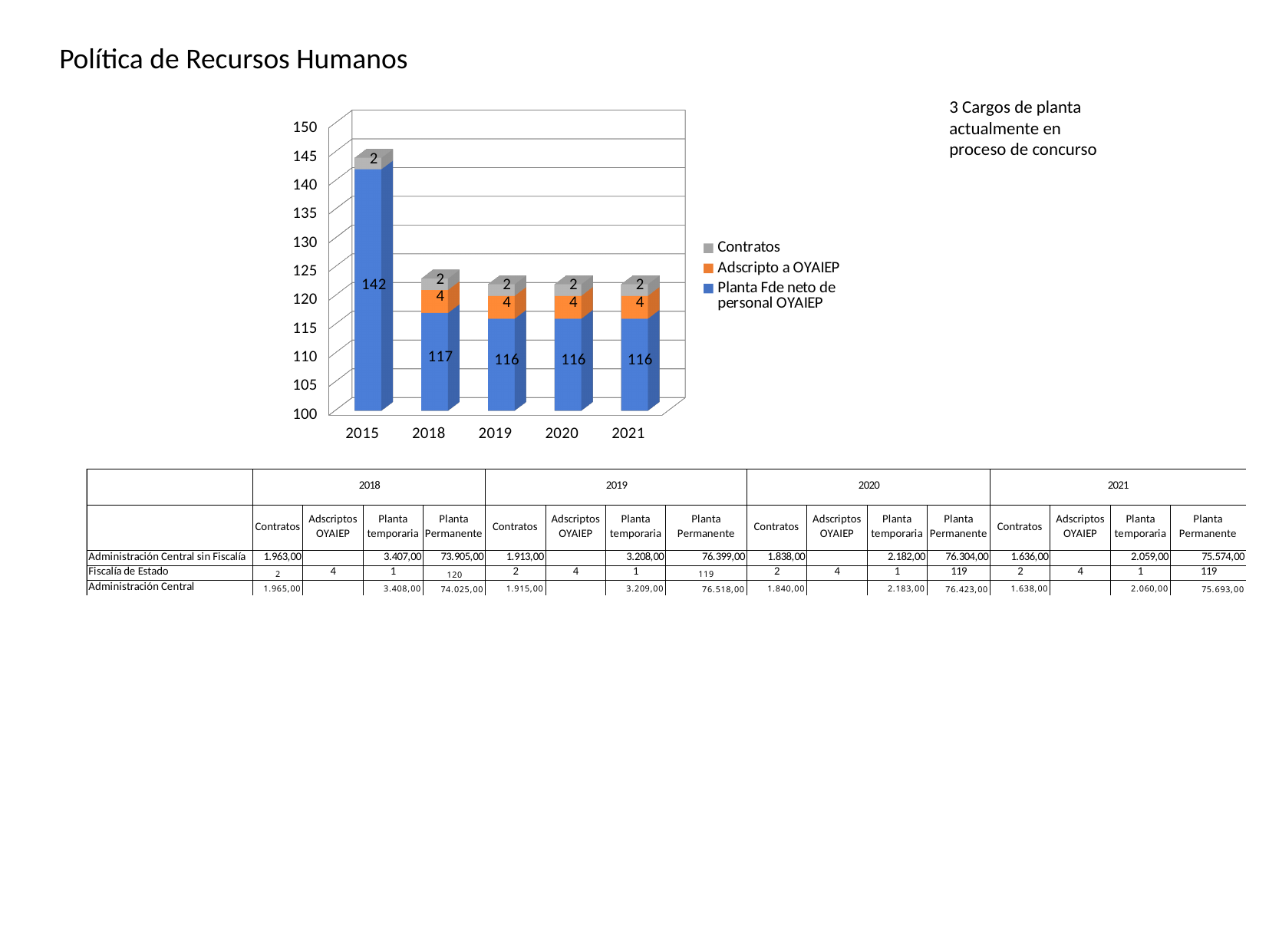
Which year has the highest value for the Planta Fde neto de personal OYAIEP series? 2015 What is the difference between the Planta Fde neto de personal OYAIEP values for 2015 and 2018? 25 How many years are shown on the x axis of the chart? 5 What is the value of the Adscripto a OYAIEP series for 2020? 4 What is the total of the stacked bar for 2015? 144 What is the value of the Contratos series for 2021? 2 What is the value of the Planta Fde neto de personal OYAIEP series for 2015? 142 Is the Planta Fde neto de personal OYAIEP value larger in 2018 or in 2019? 2018 What type of chart is shown on the slide? Stacked bar chart How many series does the chart legend list? 3 What is the value of the Planta Fde neto de personal OYAIEP series for 2018? 117 What is the total of the stacked bar for 2018? 123